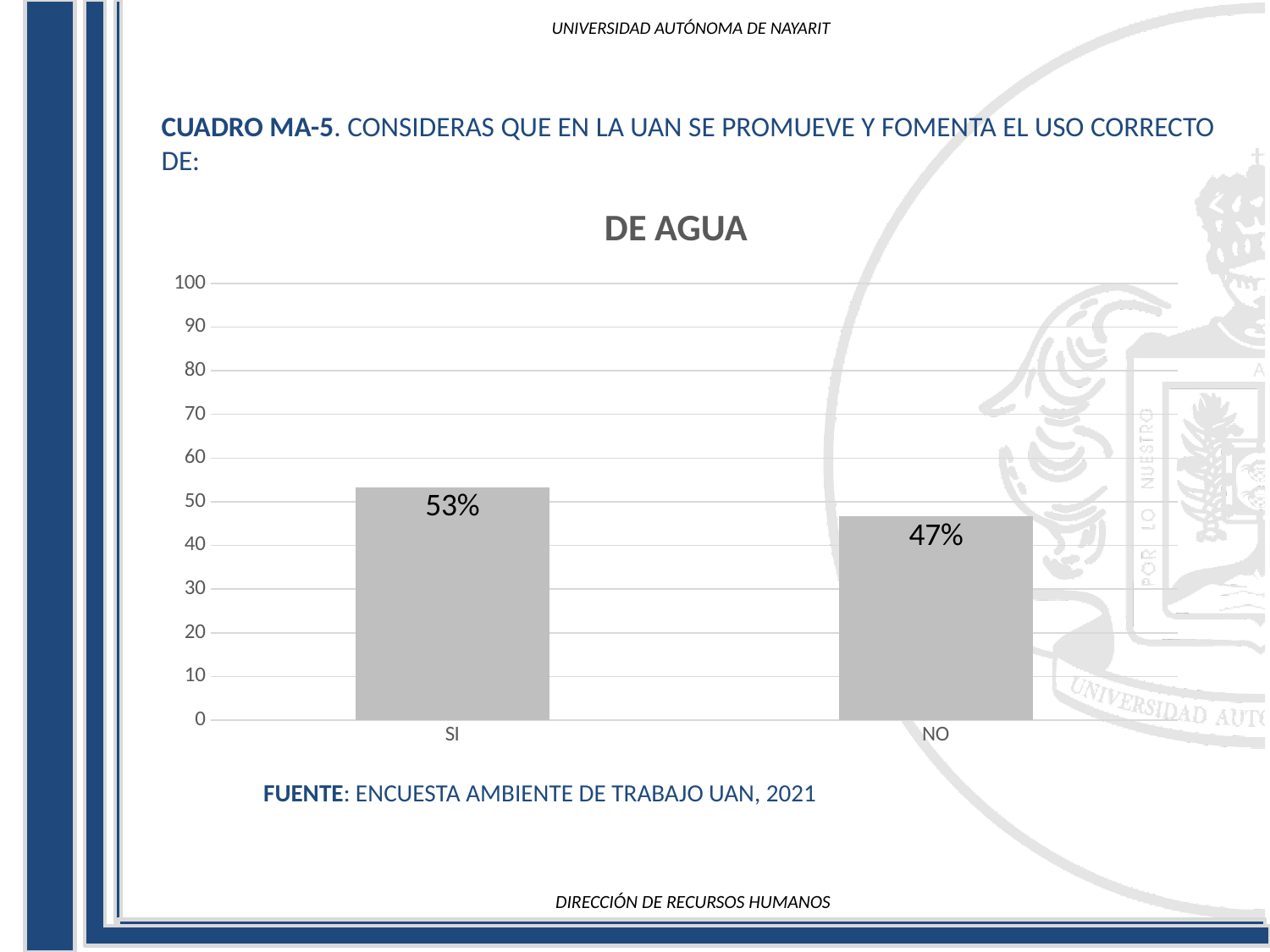
Which category has the highest value? SI What is the value for NO? 47% Which is larger, the value for SI or the value for NO? SI Is the value for SI greater or less than 50? greater What is the value for SI? 53% Is the value for NO greater or less than 50? less How many categories are shown on the x axis? 2 What kind of chart is shown? bar chart Which category has the lowest value? NO What is the title of the chart? DE AGUA What is the difference between the values for SI and NO? 6% What is the maximum value shown on the y axis? 100